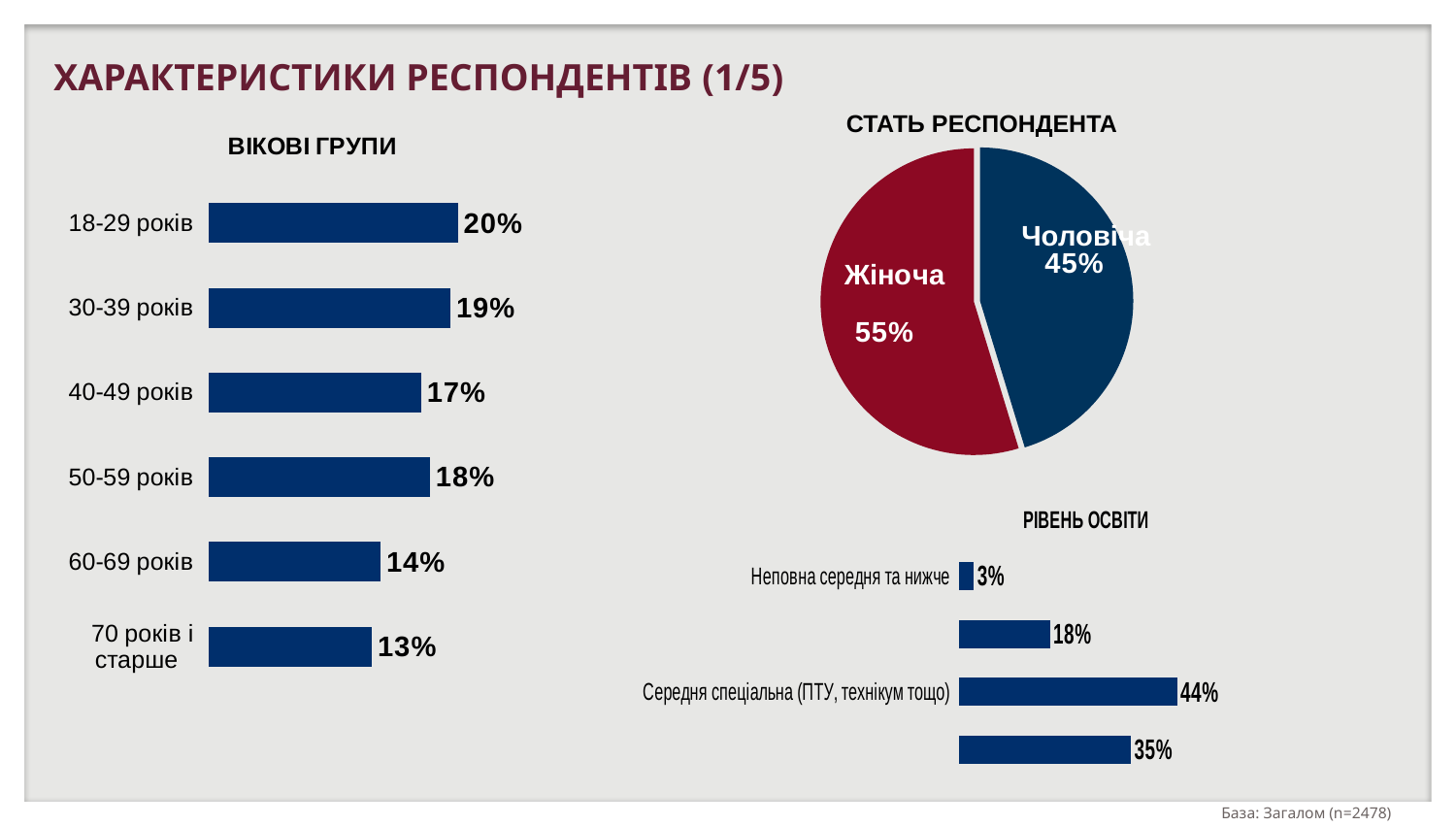
In the "СТАТЬ РЕСПОНДЕНТА" pie chart, what share is Жіноча? 55% In the "ВІКОВІ ГРУПИ" chart, how many age groups are shown? 6 In the "ВІКОВІ ГРУПИ" chart, what is the value for 60-69 років? 14% In the "СТАТЬ РЕСПОНДЕНТА" pie chart, which slice is larger, Жіноча or Чоловіча? Жіноча In the "ВІКОВІ ГРУПИ" chart, what is the value for 18-29 років? 20% In the "ВІКОВІ ГРУПИ" chart, what is the difference between the values for 18-29 років and 70 років і старше? 7 percentage points In the "ВІКОВІ ГРУПИ" chart, which age group has the highest value? 18-29 років In the "ВІКОВІ ГРУПИ" chart, which age group has the lowest value? 70 років і старше What kind of chart is the "СТАТЬ РЕСПОНДЕНТА" chart? Pie chart In the "РІВЕНЬ ОСВІТИ" chart, what is the value for Неповна середня та нижче? 3% In the "РІВЕНЬ ОСВІТИ" chart, what is the value for Середня спеціальна (ПТУ, технікум тощо)? 44% What kind of chart is the "ВІКОВІ ГРУПИ" chart? Bar chart